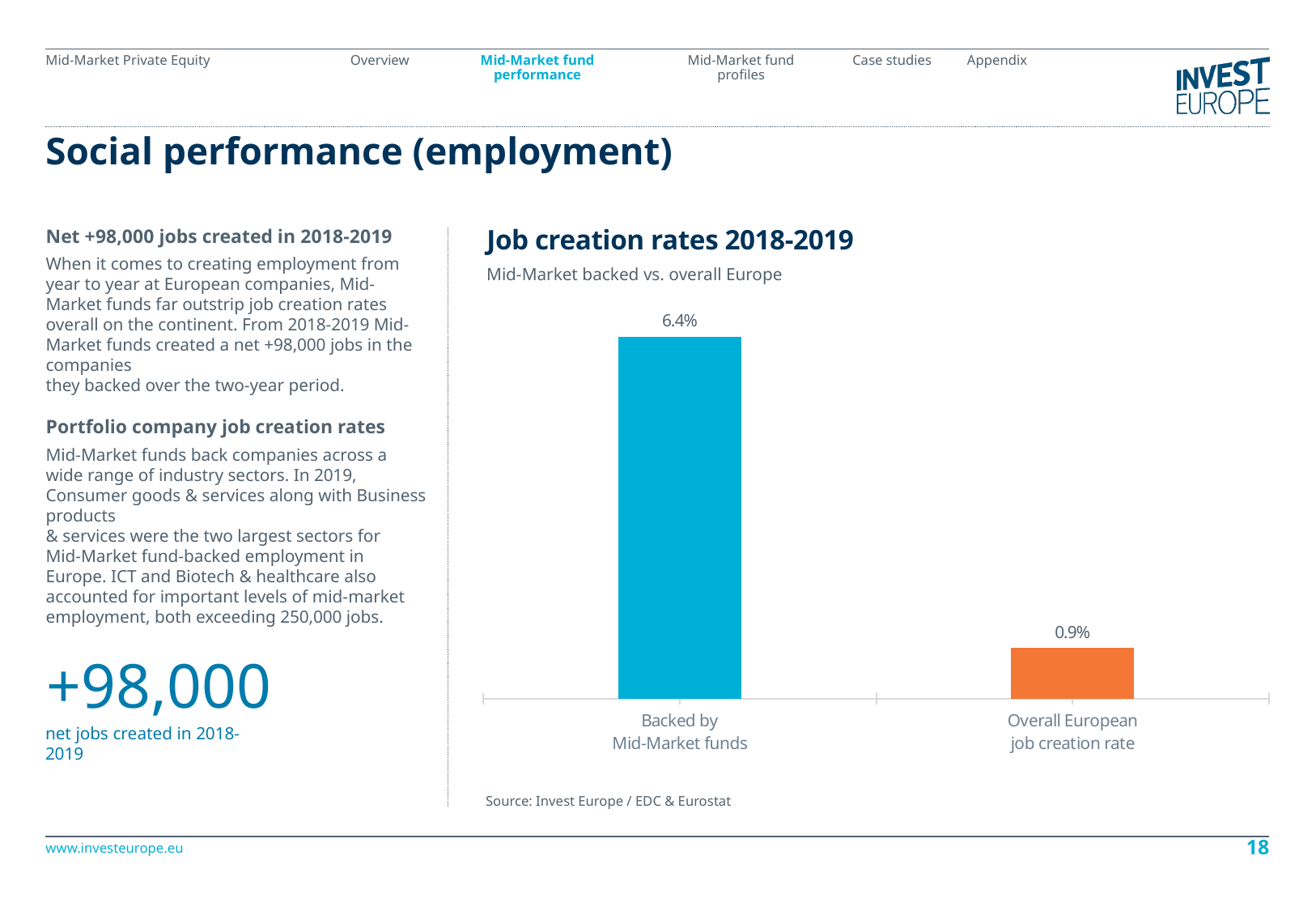
What is the title of the chart? Job creation rates 2018-2019 What is the difference between the Mid-Market backed job creation rate and the overall European job creation rate? 5.5% Which category has the lower job creation rate? Overall European job creation rate Is the job creation rate higher for companies backed by Mid-Market funds or for overall Europe? Backed by Mid-Market funds How many categories are plotted in the chart? 2 What is the job creation rate for companies backed by Mid-Market funds? 6.4% What kind of chart is shown on the slide? Bar chart What is the overall European job creation rate shown in the chart? 0.9% What is the subtitle of the chart? Mid-Market backed vs. overall Europe Which category has the higher job creation rate? Backed by Mid-Market funds